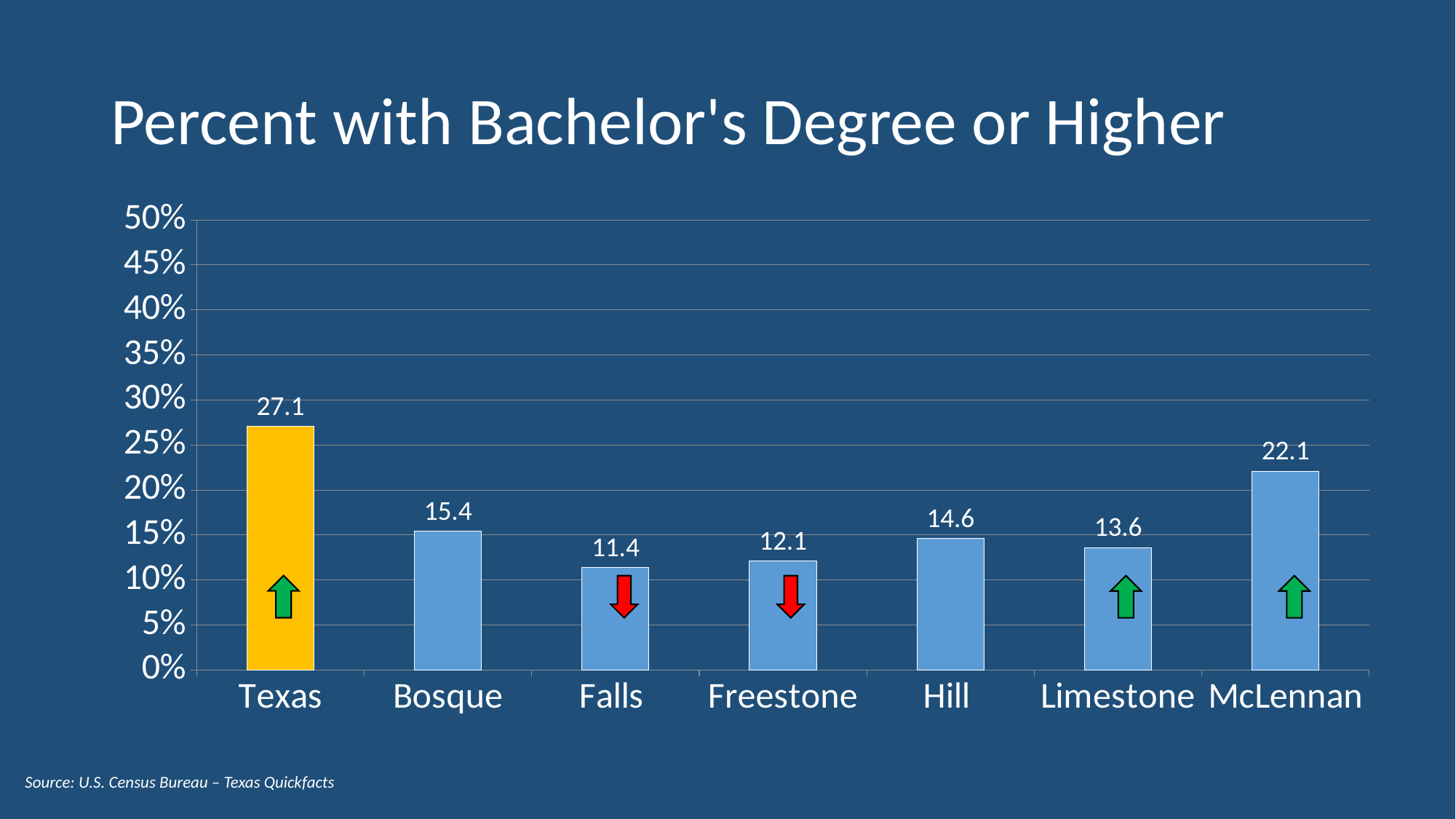
Which category has the highest value? Texas What kind of chart is shown on the slide? bar chart Is the value for McLennan greater or less than 20%? greater Which category has the lowest value? Falls What is the value for Texas? 27.1 What is the title of the chart? Percent with Bachelor's Degree or Higher What is the value for McLennan? 22.1 What is the value for Falls? 11.4 How many categories are shown on the x axis? 7 What is the difference between the values for Texas and McLennan? 5.0 What is the difference between the values for Bosque and Hill? 0.8 Which is larger, the value for Limestone or the value for Freestone? Limestone